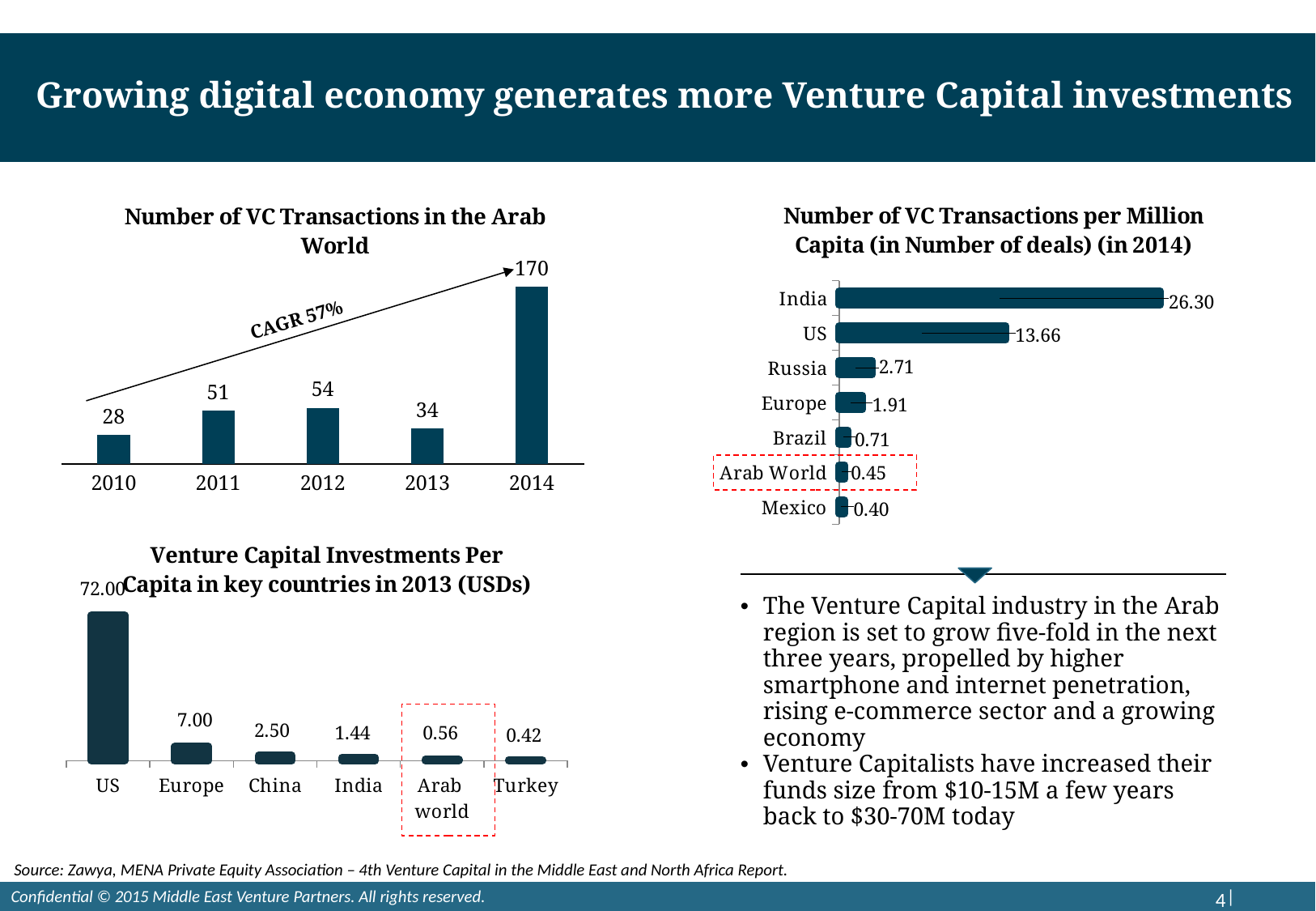
In the 'Number of VC Transactions in the Arab World' chart, what is the difference between the 2012 and 2013 values? 20 In the 'Number of VC Transactions in the Arab World' chart, what is the value for 2014? 170 In the 'Number of VC Transactions per Million Capita' chart, which country has the highest value? India What type of chart is the 'Venture Capital Investments Per Capita in key countries in 2013' chart? Bar chart In the 'Venture Capital Investments Per Capita in key countries in 2013' chart, what is the value for the Arab world? 0.56 In the 'Number of VC Transactions in the Arab World' chart, which year has the lowest value? 2010 In the 'Number of VC Transactions in the Arab World' chart, how many years are shown? 5 In the 'Number of VC Transactions per Million Capita' chart, what is the value for Russia? 2.71 In the 'Venture Capital Investments Per Capita in key countries in 2013' chart, which is larger, Europe or China? Europe In the 'Number of VC Transactions per Million Capita' chart, what is the difference between India and the US? 12.64 In the 'Number of VC Transactions per Million Capita' chart, which category has the lowest value? Mexico In the 'Number of VC Transactions in the Arab World' chart, what CAGR is printed on the slide? CAGR 57%